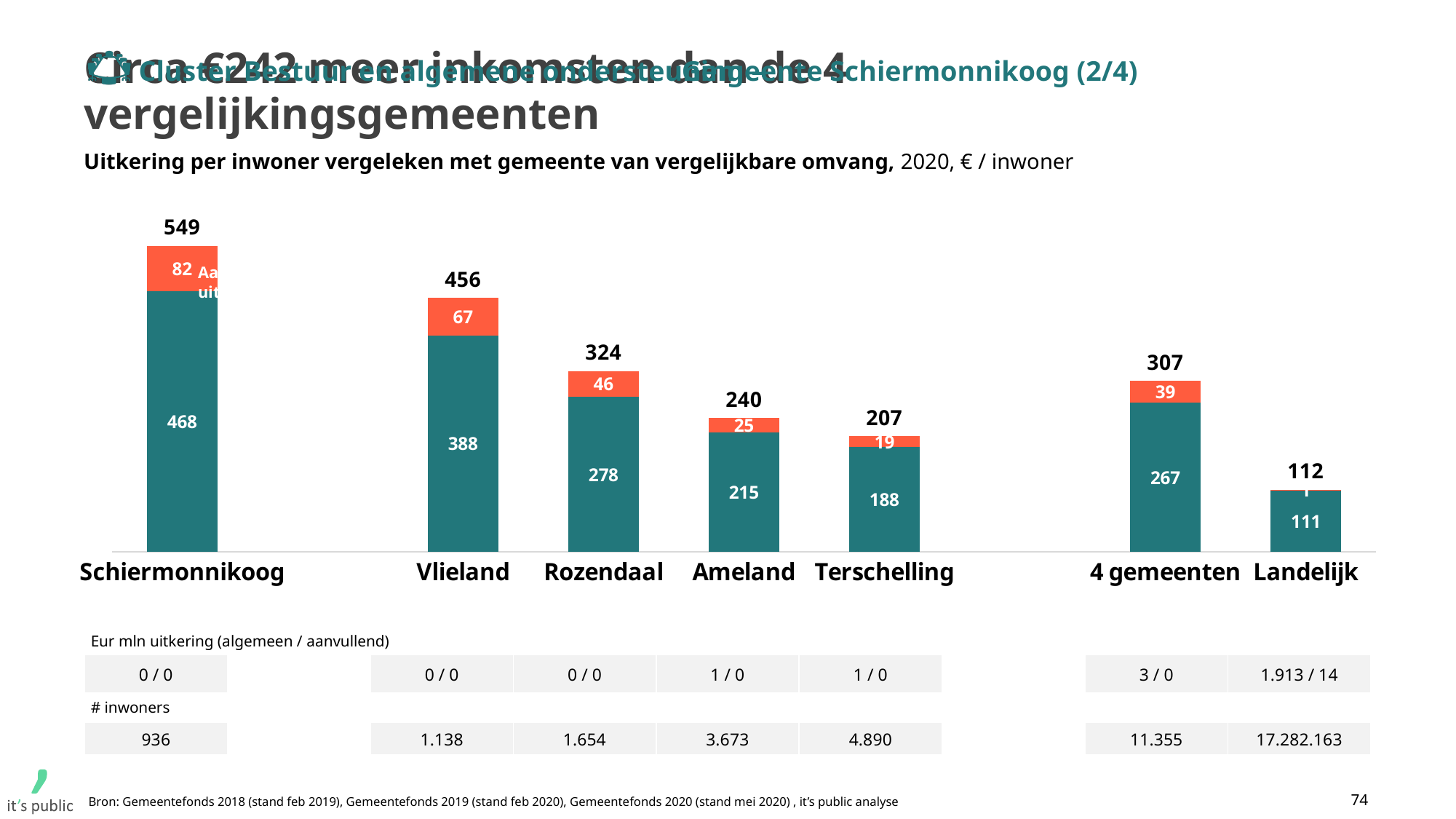
Which category has the lowest total value? Landelijk How many categories (bars) are shown in the chart? 7 What unit is stated in the chart subtitle for the values? € / inwoner What is the total value shown above the bar for 4 gemeenten? 307 Which has a larger total value, Ameland or Terschelling? Ameland What is the total value shown above the bar for Schiermonnikoog? 549 What is the sum of the teal segment (215) and the orange segment (25) for Ameland? 240 What is the value of the teal (lower) segment of the Vlieland bar? 388 What kind of chart is shown on the slide? Stacked bar chart Which category has the highest total value? Schiermonnikoog What is the difference between the total for Schiermonnikoog and the total for 4 gemeenten? 242 What is the value of the orange (upper) segment of the Rozendaal bar? 46